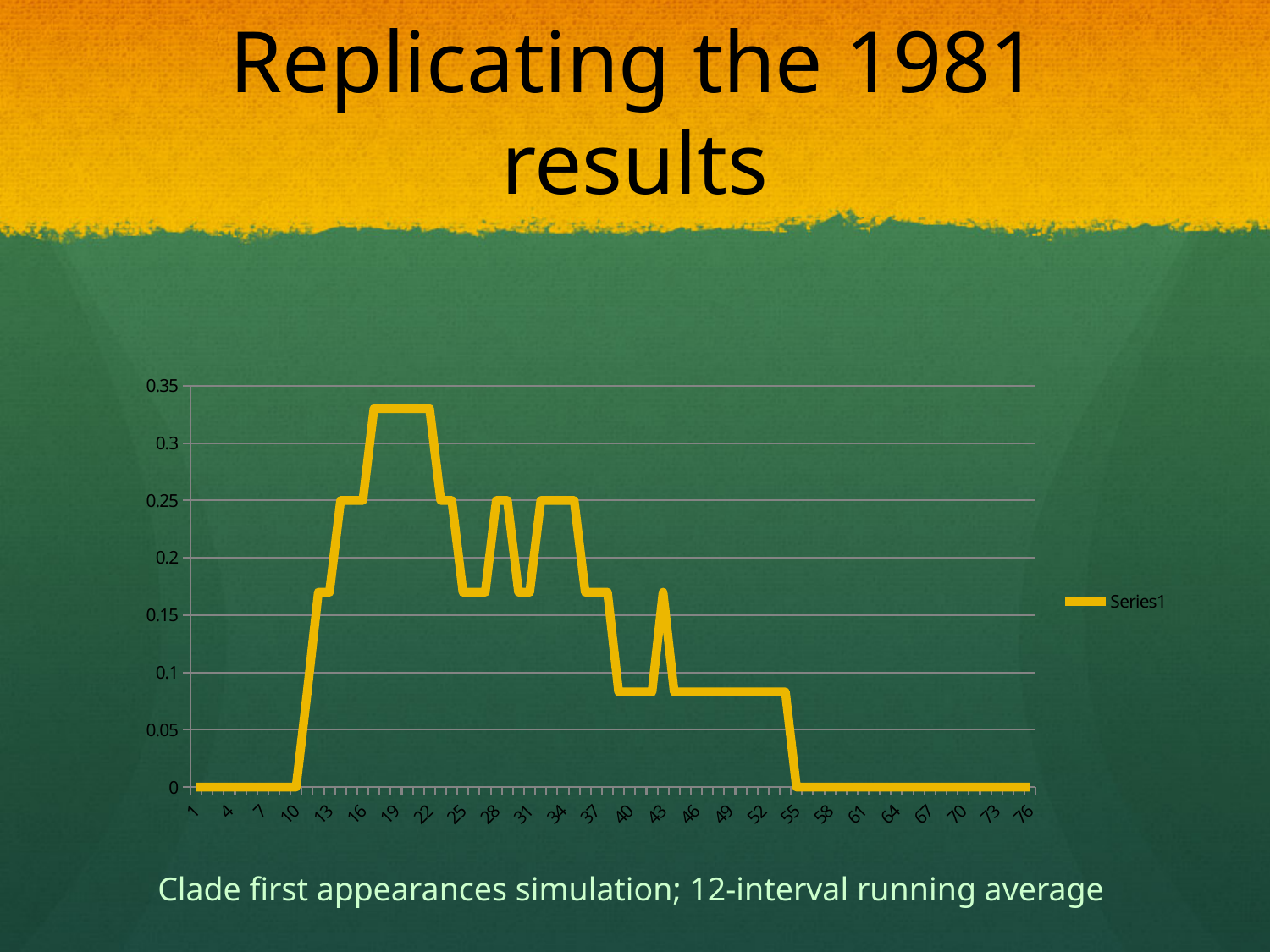
Is the value for Series1 at x = 13 greater or less than 0.15? greater Is the value for Series1 at x = 49 greater or less than 0.1? less What is the highest value shown on the y axis? 0.35 What kind of chart is shown on the slide? line chart Is the value for Series1 at x = 58 greater or less than 0.05? less What is the value for Series1 at x = 76? 0 Does the line rise or fall between x = 10 and x = 16? rise What is the name of the series shown in the legend? Series1 Which has the larger value for Series1, x = 19 or x = 43? 19 How many series does the legend list? 1 What is the value for Series1 at x = 1? 0